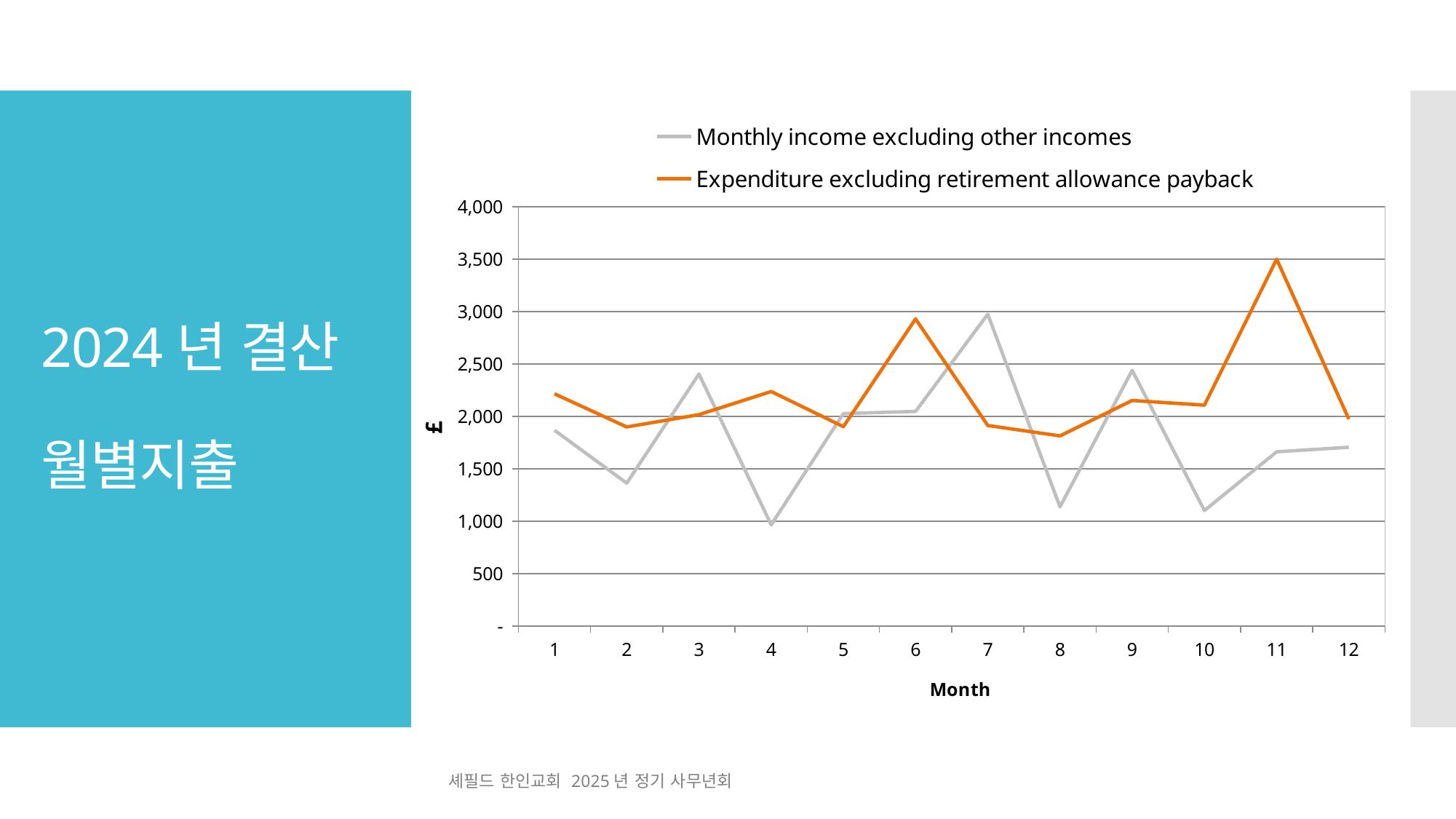
In which month is the Monthly income excluding other incomes lowest? 4 In which month is the Expenditure excluding retirement allowance payback highest? 11 In month 4, which is larger: Monthly income excluding other incomes or Expenditure excluding retirement allowance payback? Expenditure excluding retirement allowance payback In month 7, which is larger: Monthly income excluding other incomes or Expenditure excluding retirement allowance payback? Monthly income excluding other incomes Is the Monthly income excluding other incomes in month 2 greater or less than 1,500? less How many series does the chart legend list? 2 Is the Expenditure excluding retirement allowance payback in month 11 greater or less than 3,000? greater In which month is the Monthly income excluding other incomes highest? 7 How many months are plotted along the x axis? 12 Is the Expenditure excluding retirement allowance payback in month 6 greater or less than 2,500? greater What is the title of the vertical axis? £ What kind of chart is shown on the slide? line chart